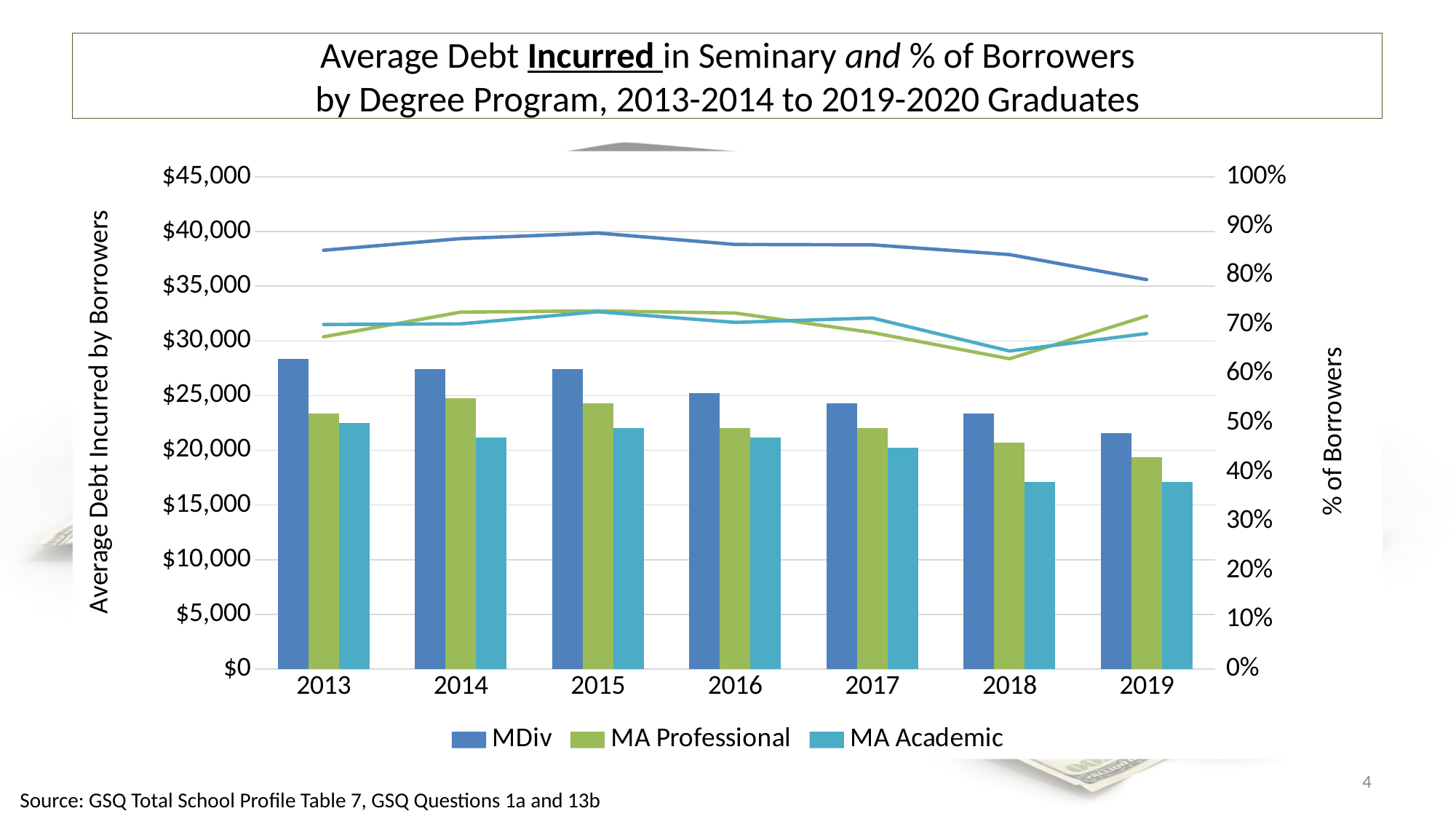
What kind of chart is shown on the slide? A bar chart combined with line series Which degree program has the highest % of borrowers line in every year shown? MDiv What is the label of the right-hand vertical axis? % of Borrowers Is the MA Academic average debt bar for 2018 greater or less than $20,000? less Is the MDiv % of borrowers line for 2015 greater or less than 80%? greater In which year is the MDiv average debt bar the highest? 2013 How many years are shown along the x axis? 7 Do the MDiv average debt bars rise or fall from 2013 to 2019? fall Is the MDiv average debt bar for 2013 greater or less than $25,000? greater In 2014, which has the larger average debt bar: MA Professional or MA Academic? MA Professional In which year is the MDiv average debt bar the lowest? 2019 How many series does the legend list? 3